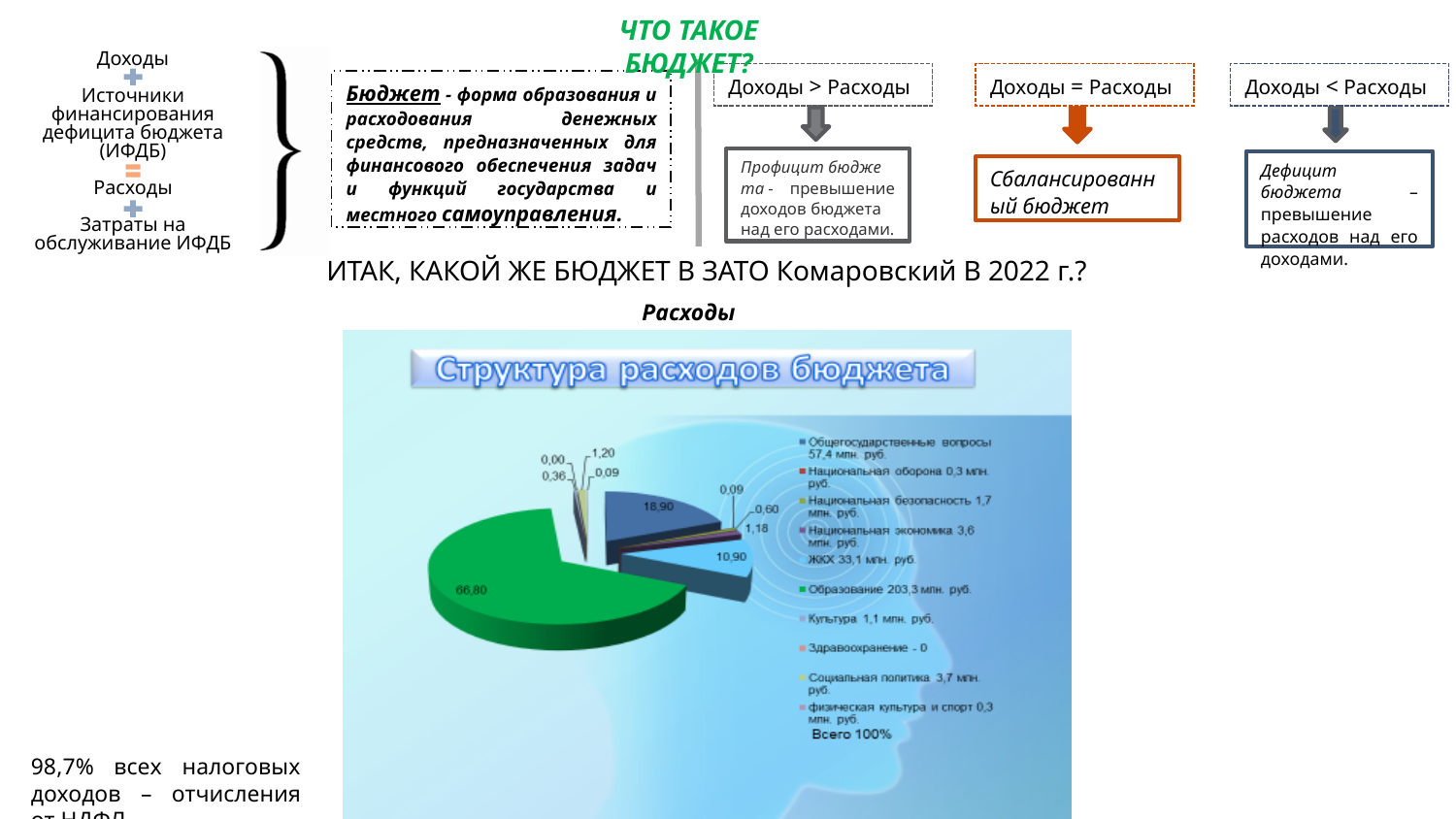
How many categories does the legend of the pie chart list? 10 According to the legend, what is the amount for Здравоохранение? 0 According to the legend, what is the amount for Общегосударственные вопросы? 57,4 млн. руб. What kind of chart is shown under the heading 'Структура расходов бюджета'? pie chart What is the difference between the legend amounts for Общегосударственные вопросы and ЖКХ? 24,3 млн. руб. What total is stated at the bottom of the legend? Всего 100% Which is larger according to the legend: Национальная экономика or Социальная политика? Социальная политика Which legend category has the largest amount? Образование According to the legend, what is the amount for ЖКХ? 33,1 млн. руб. What is the title of the chart on the slide? Структура расходов бюджета What is the largest data label shown on the pie chart? 66,80 According to the legend, what is the amount for Образование? 203,3 млн. руб.